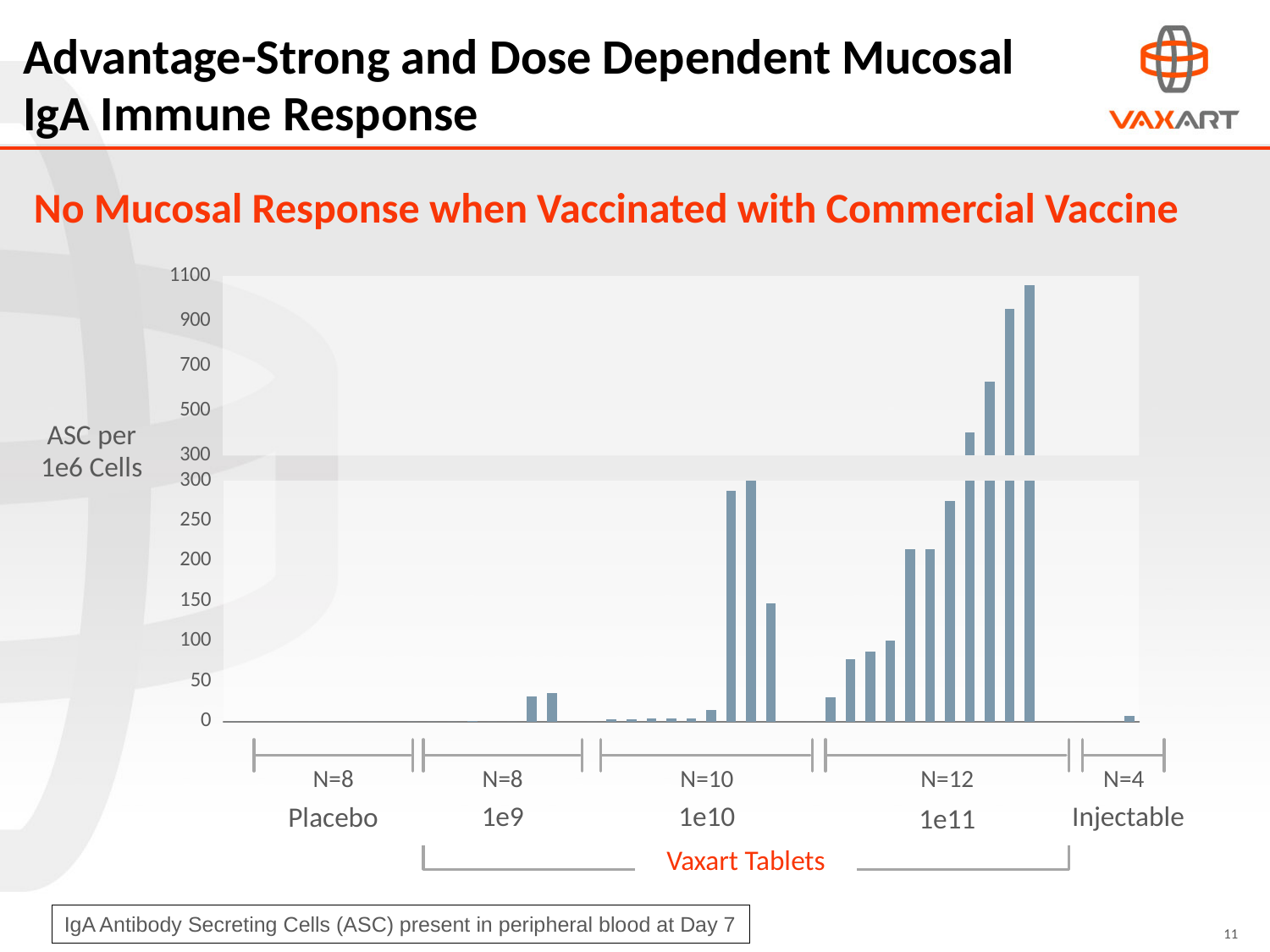
Is the tallest bar in the 1e10 group greater or less than 250? greater Which group has the larger tallest bar, 1e9 or 1e10? 1e10 Is the tallest bar in the 1e11 group greater or less than 900? greater How many dose groups are labelled along the x axis of the chart? 5 Is the value for the Injectable group's bar greater or less than 50? less Which group contains the tallest bar in the chart? 1e11 Do the bar heights generally rise or fall as the Vaxart tablet dose increases from 1e9 to 1e11? rise What is the label on the y axis of the chart? ASC per 1e6 Cells What is the sample size (N) shown for the Injectable group? N=4 What is the sample size (N) shown for the 1e11 group? N=12 What kind of chart is shown on the slide? bar chart Which groups are bracketed together under the label 'Vaxart Tablets'? 1e9, 1e10 and 1e11